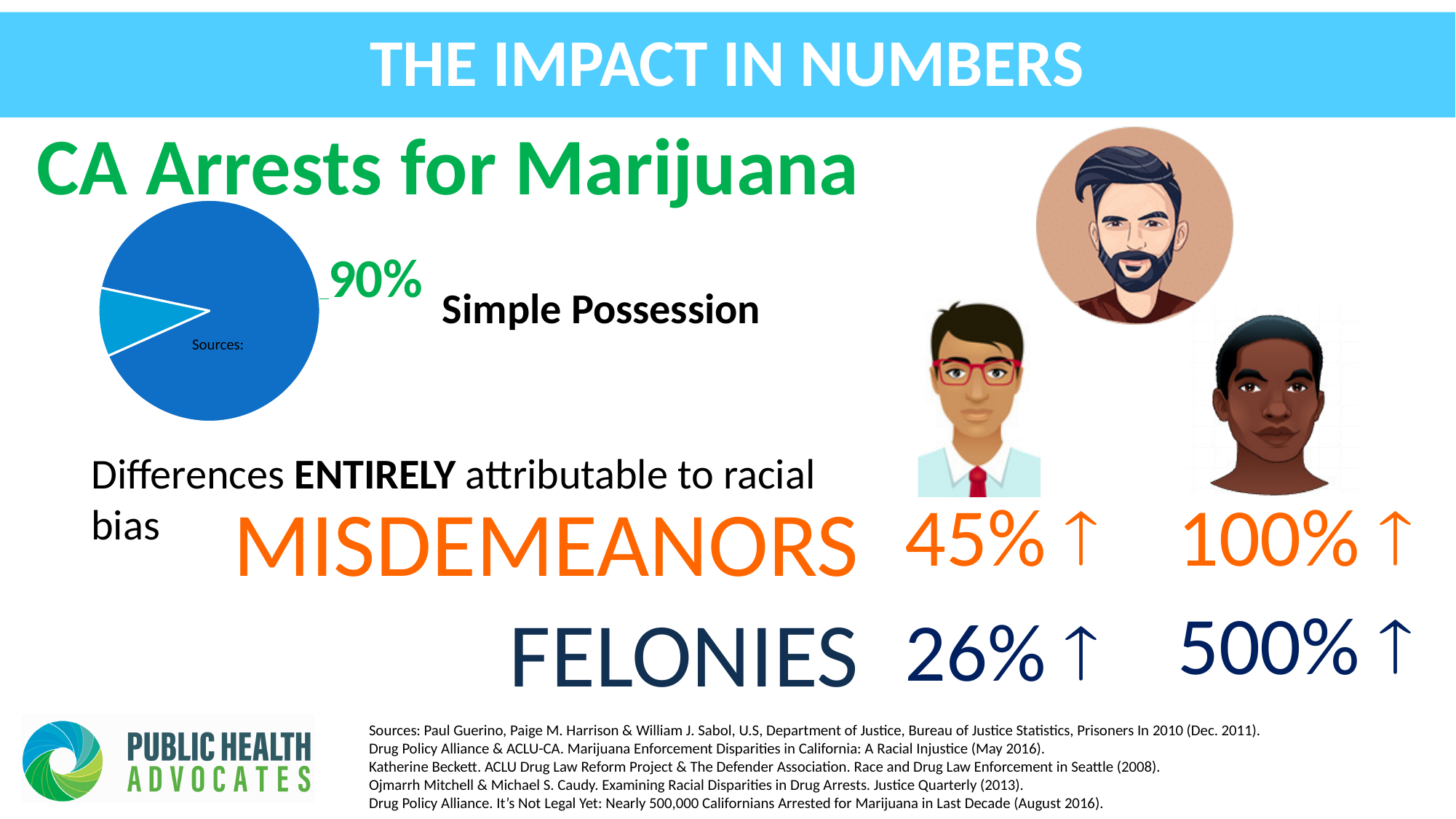
What is the heading above the pie chart? CA Arrests for Marijuana What kind of chart is shown under the heading "CA Arrests for Marijuana"? pie chart Which slice of the pie chart is larger, the dark blue slice or the light blue slice? the dark blue slice Which category makes up the largest slice of the pie chart? Simple Possession What share of CA arrests for marijuana does the pie chart attribute to Simple Possession? 90% Is the smaller, light blue slice of the pie chart greater or less than 50%? less What colour is the Simple Possession slice of the pie chart? dark blue How many slices does the pie chart have? 2 Is the share for Simple Possession in the pie chart greater or less than 50%? greater